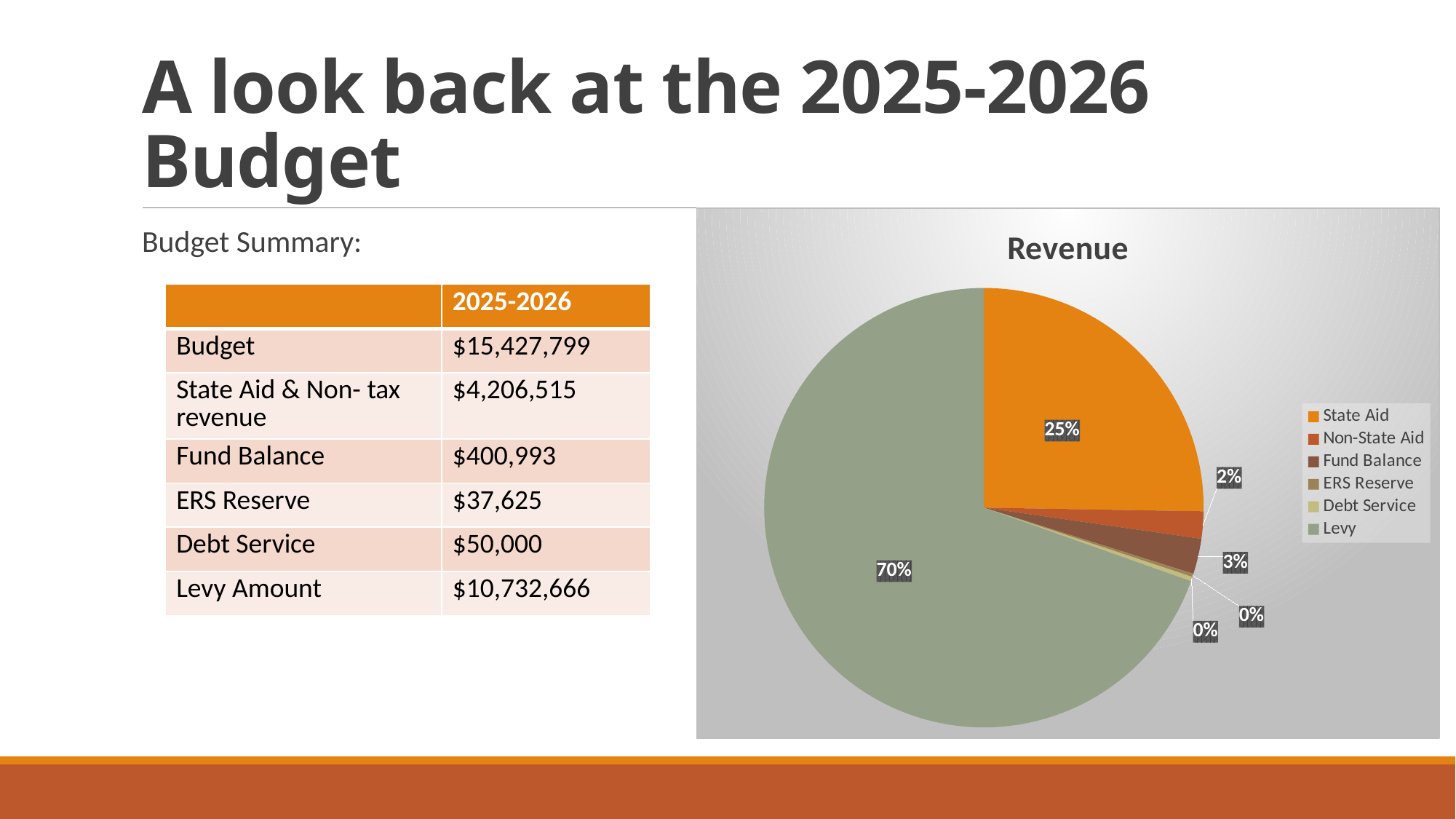
Which category has the largest slice of the pie? Levy What share of the pie does Levy represent? 70% What is the title of the chart? Revenue Which is larger, the State Aid slice or the Fund Balance slice? State Aid What kind of chart is shown on the slide? pie chart How many entries does the chart's legend list? 6 How many slices does the pie chart have? 6 What share of the pie does State Aid represent? 25% What share of the pie does Fund Balance represent? 3% By how many percentage points does the Levy share exceed the State Aid share? 45 Which legend entry is shown in green? Levy